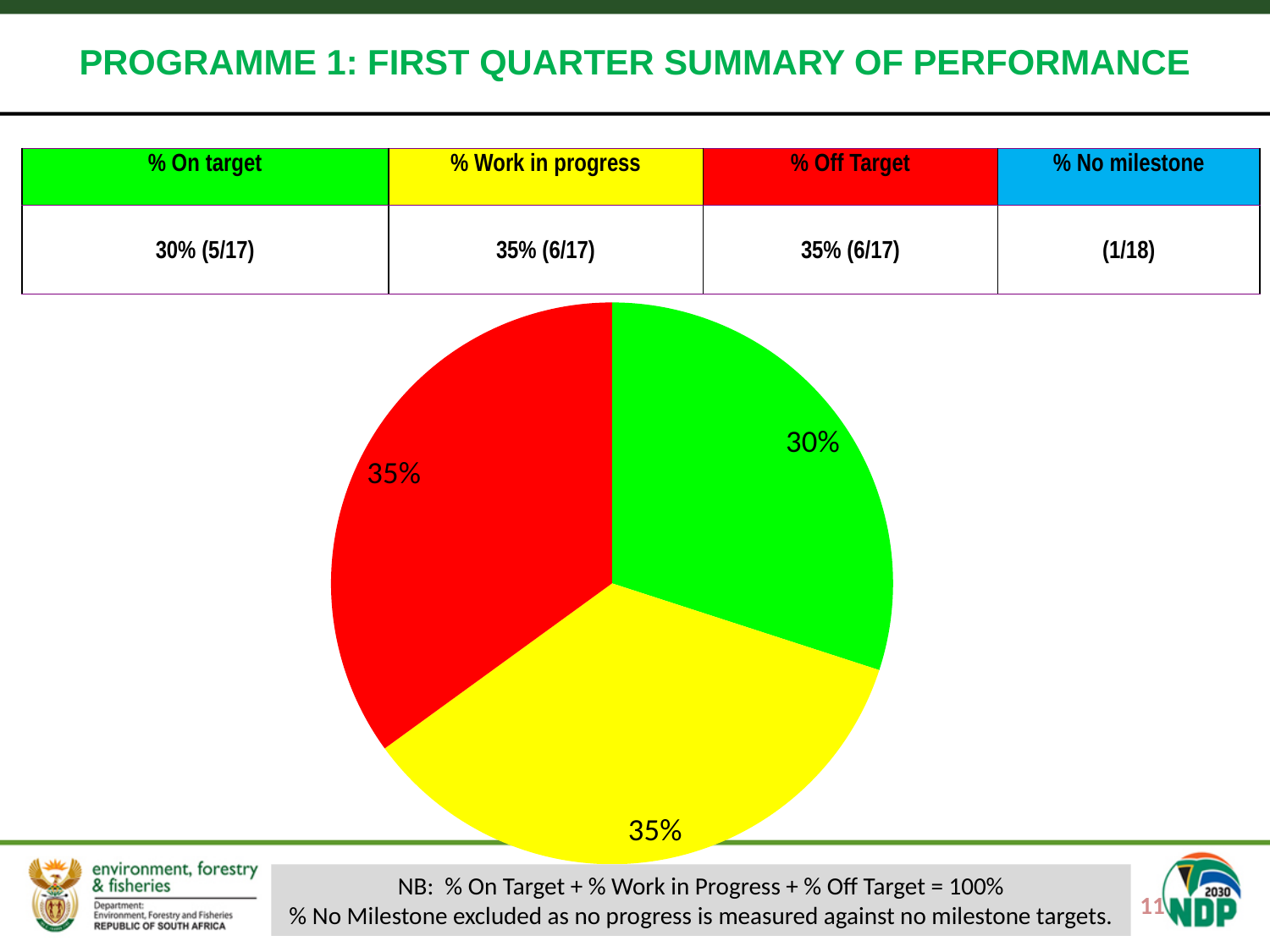
What percentage is shown on the green slice of the pie chart? 30% According to the table's colour key, what share of the pie does % On target represent? 30% What percentage is shown on the yellow slice of the pie chart? 35% What percentage is shown on the red slice of the pie chart? 35% What is the title of the slide containing the pie chart? PROGRAMME 1: FIRST QUARTER SUMMARY OF PERFORMANCE What kind of chart is shown on the slide? pie chart Which colour represents % Work in progress in the table above the pie chart? yellow What is the total of the three percentages shown on the pie chart? 100% What is the difference between the % Off Target slice and the % On target slice? 5% How many slices does the pie chart have? 3 Which is larger in the pie chart, the green slice or the red slice? the red slice Which category has the smallest slice in the pie chart? % On target